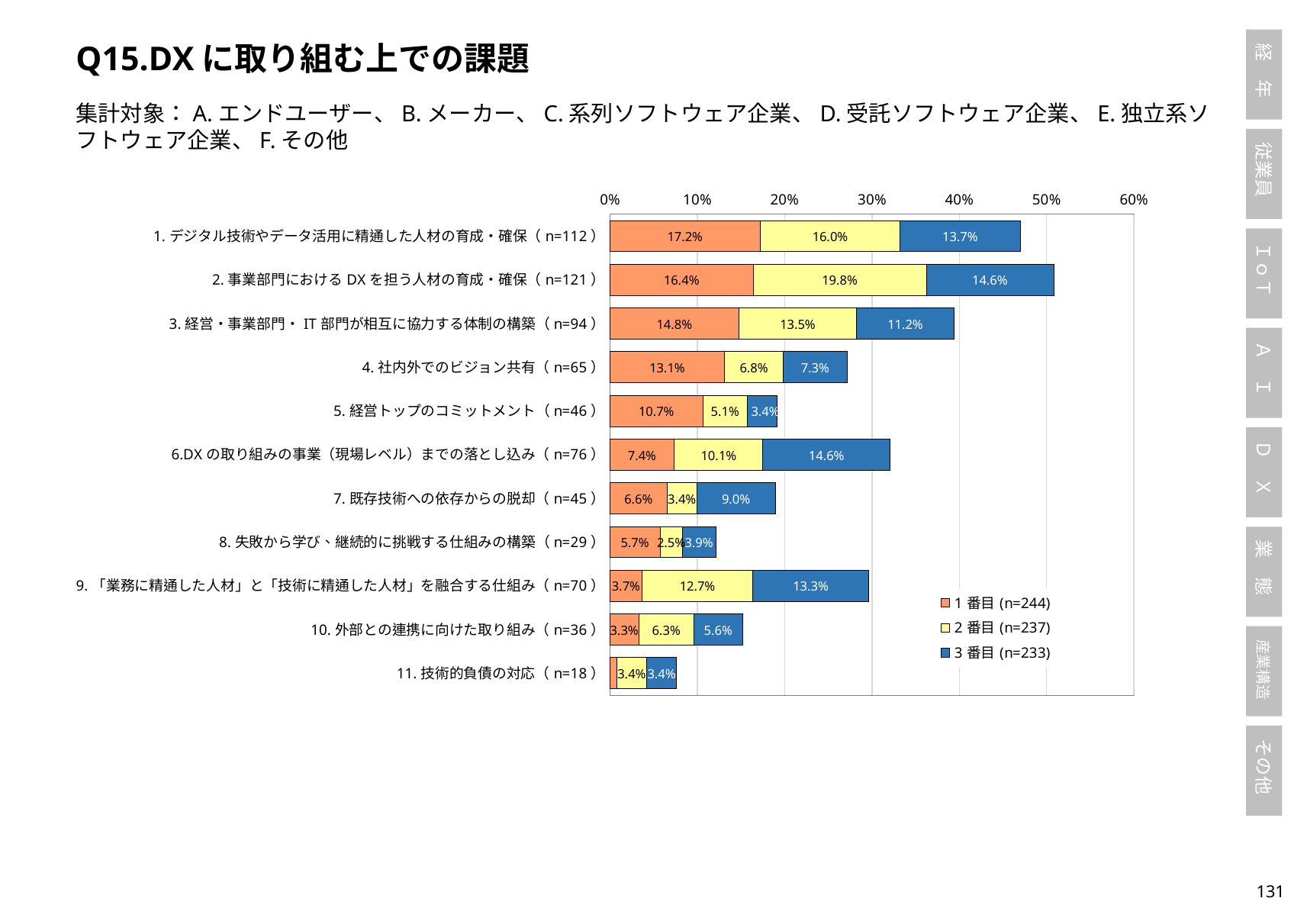
What is the difference between the 2番目 values of item 2 (19.8%) and item 1 (16.0%)? 3.8% Which category has the highest 2番目 value? 2. 事業部門におけるDXを担う人材の育成・確保 What is the 3番目 value for "6.DXの取り組みの事業（現場レベル）までの落とし込み"? 14.6% How many categories (課題 items) are plotted in the chart? 11 What kind of chart is shown on the slide? Stacked bar chart What is the 2番目 value for "2. 事業部門におけるDXを担う人材の育成・確保"? 19.8% How many series does the legend list? 3 Which is larger: the 3番目 value for "4. 社内外でのビジョン共有" or the 3番目 value for "7. 既存技術への依存からの脱却"? 7. 既存技術への依存からの脱却 Which category has the highest 1番目 value? 1. デジタル技術やデータ活用に精通した人材の育成・確保 What is the total of the stacked bar for "1. デジタル技術やデータ活用に精通した人材の育成・確保"? 46.9% Is the total length of the stacked bar for "2. 事業部門におけるDXを担う人材の育成・確保" greater or less than 50%? greater What is the 1番目 value for "1. デジタル技術やデータ活用に精通した人材の育成・確保"? 17.2%